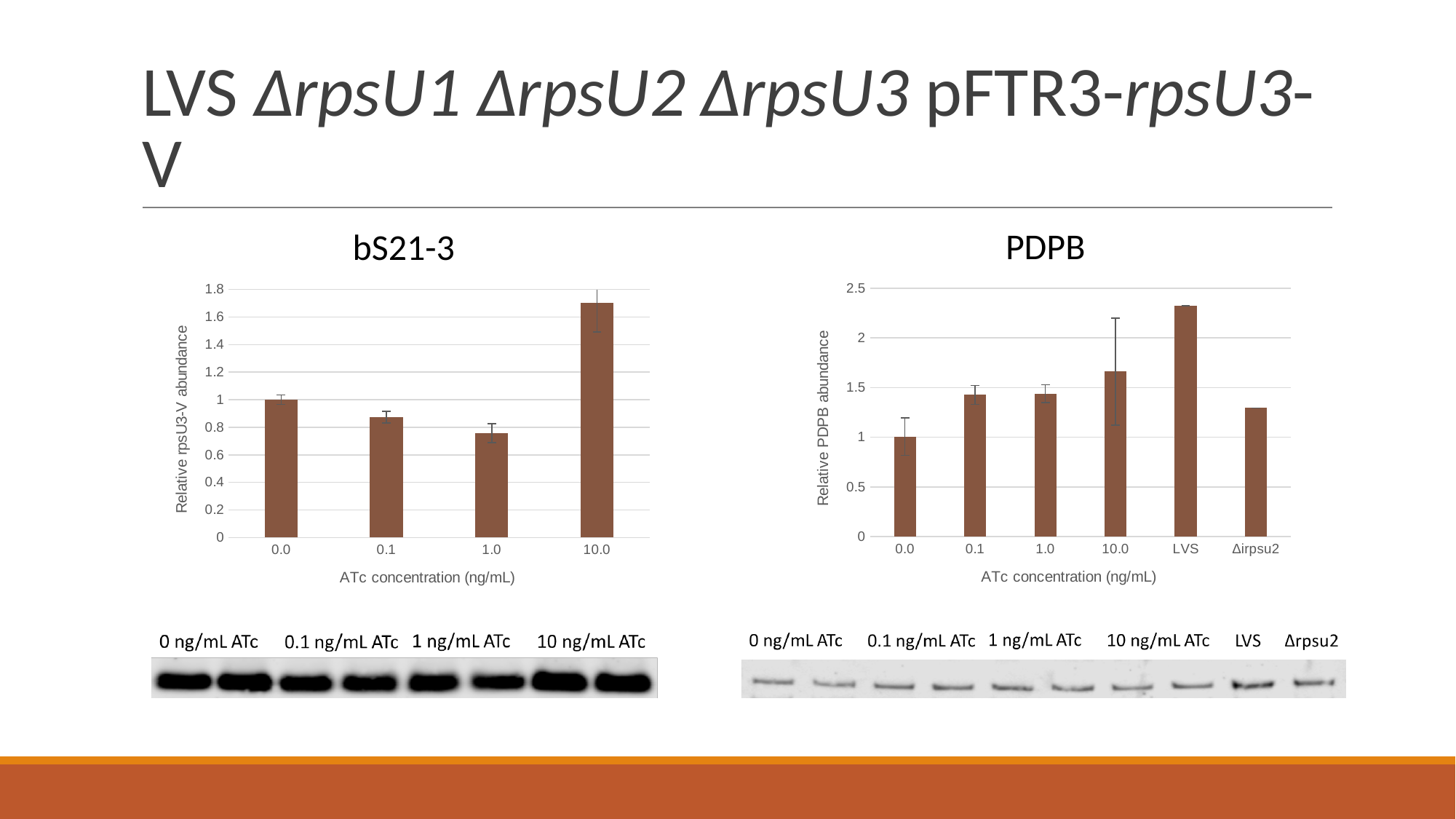
In the PDPB chart, how many categories are plotted on the x axis? 6 In the bS21-3 chart, is the value for 10.0 ng/mL ATc greater or less than 1.4? greater In the bS21-3 chart, which has the larger value, 0.1 or 1.0 ng/mL ATc? 0.1 In the PDPB chart, which category has the highest relative PDPB abundance? LVS In the bS21-3 chart, how many ATc concentration categories are plotted? 4 What is the y-axis title of the PDPB chart? Relative PDPB abundance In the bS21-3 chart, which ATc concentration has the highest relative rpsU3-V abundance? 10.0 In the bS21-3 chart, which ATc concentration has the lowest relative rpsU3-V abundance? 1.0 In the PDPB chart, which has the larger value, 10.0 or Δirpsu2? 10.0 What kind of chart is the bS21-3 chart? bar chart In the PDPB chart, is the value for LVS greater or less than 2? greater In the PDPB chart, which category has the lowest relative PDPB abundance? 0.0